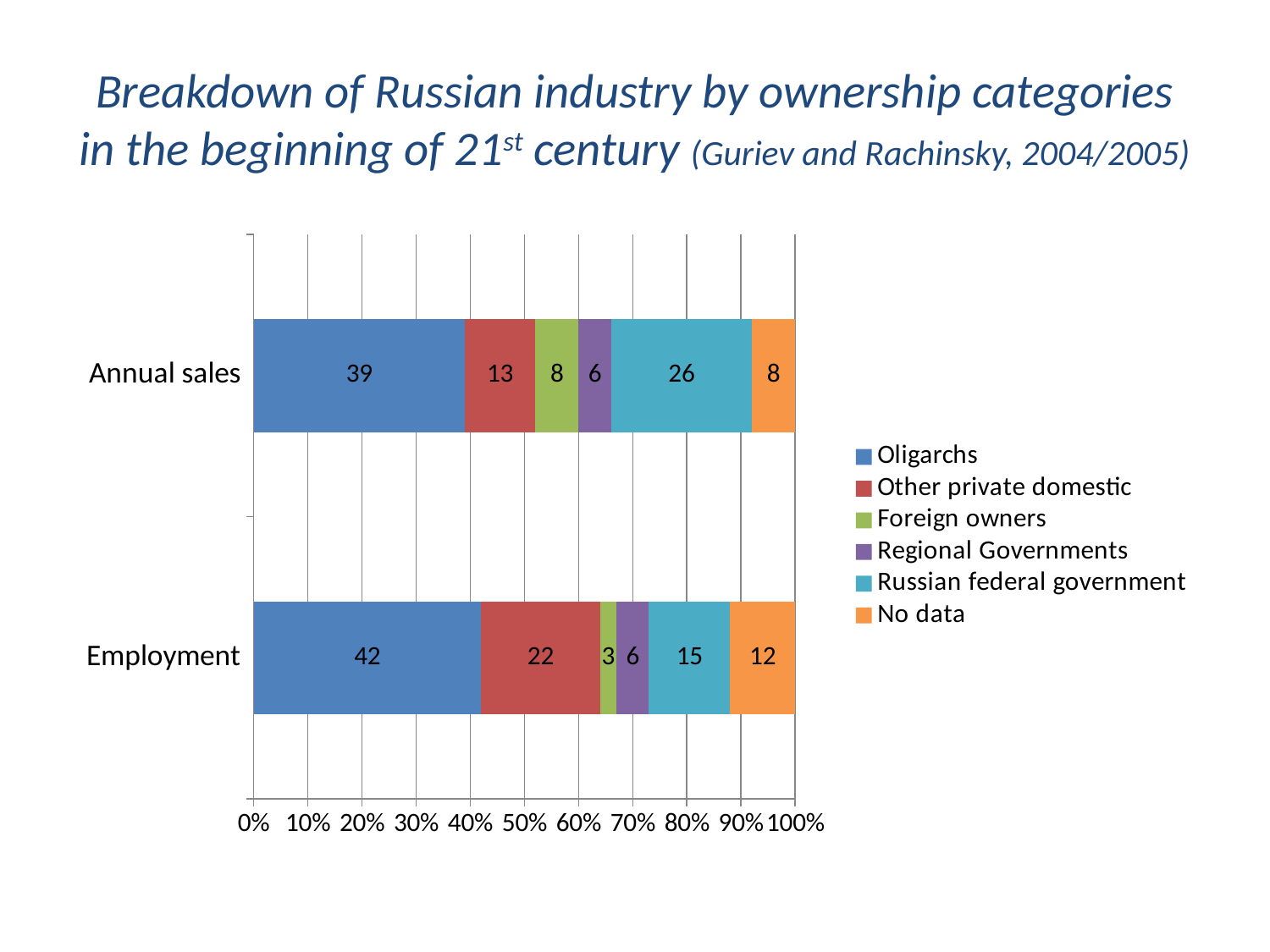
Which ownership category has the largest share of Employment? Oligarchs Which is larger: the Russian federal government value for Annual sales or for Employment? Annual sales What is the Oligarchs value for Annual sales? 39 Which ownership category has the smallest share of Annual sales? Regional Governments What is the Foreign owners value for Employment? 3 What is the difference between the Oligarchs values for Employment and Annual sales? 3 How many categories are shown on the vertical axis? 2 What is the total of the Employment bar? 100 What is the Russian federal government value for Annual sales? 26 What kind of chart is shown on the slide? Stacked bar chart What is the Other private domestic value for Employment? 22 How many series does the legend list? 6